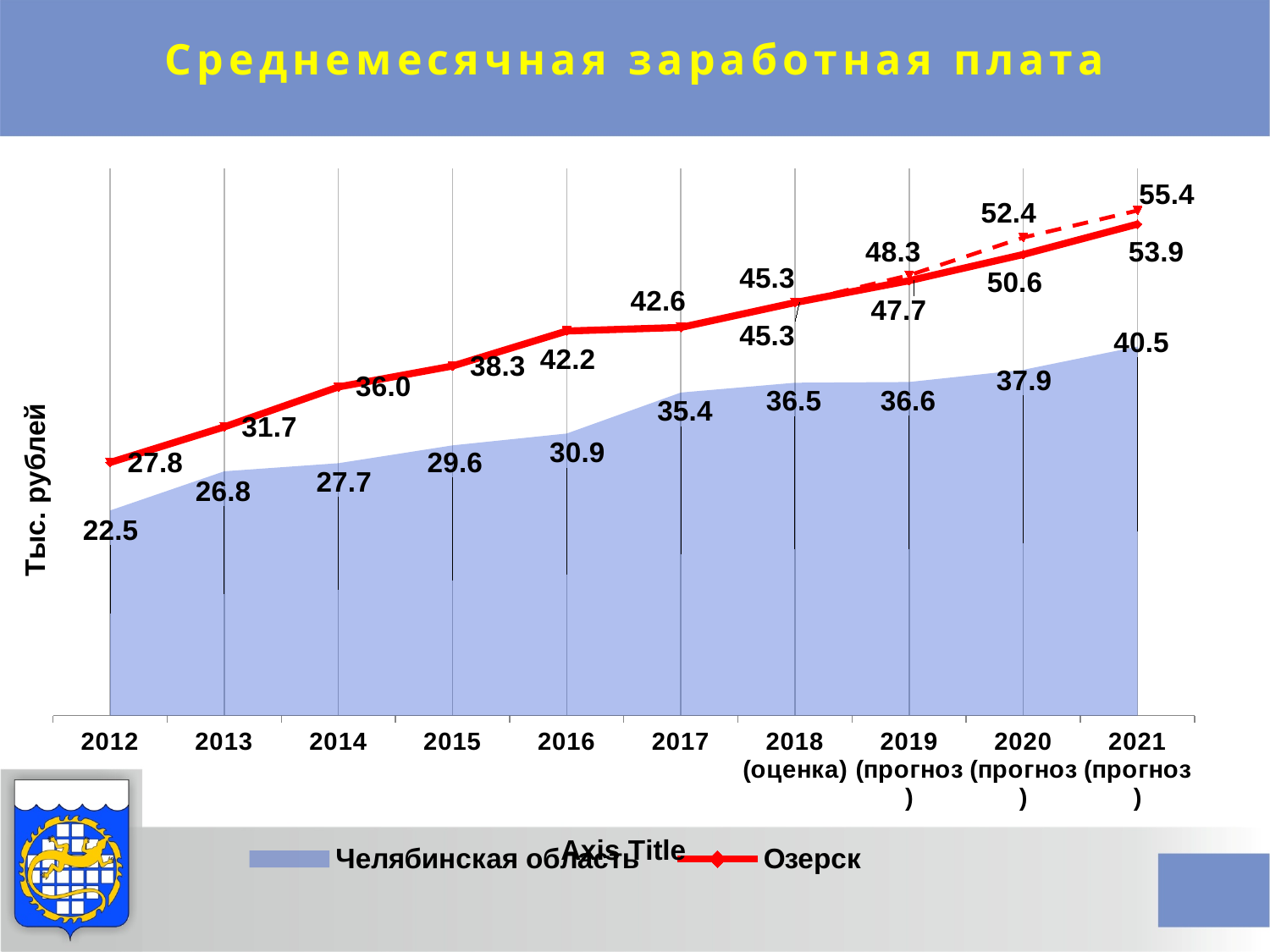
In which year is the value for Челябинская область the lowest? 2012 How many years are shown on the x axis? 10 What is the value for Челябинская область in 2012? 22.5 Which series has the larger value in 2015, Озерск or Челябинская область? Озерск In which year is the value for Челябинская область the highest? 2021 (прогноз) What is the difference between the Озерск and Челябинская область values in 2016? 11.3 What is the value for Озерск in 2016? 42.2 What is the value for Челябинская область in 2017? 35.4 Do the values for Челябинская область rise or fall from 2012 to 2021? rise What is the value for Озерск in 2014? 36.0 How many series does the legend list? 2 What is the difference between the Озерск and Челябинская область values in 2012? 5.3